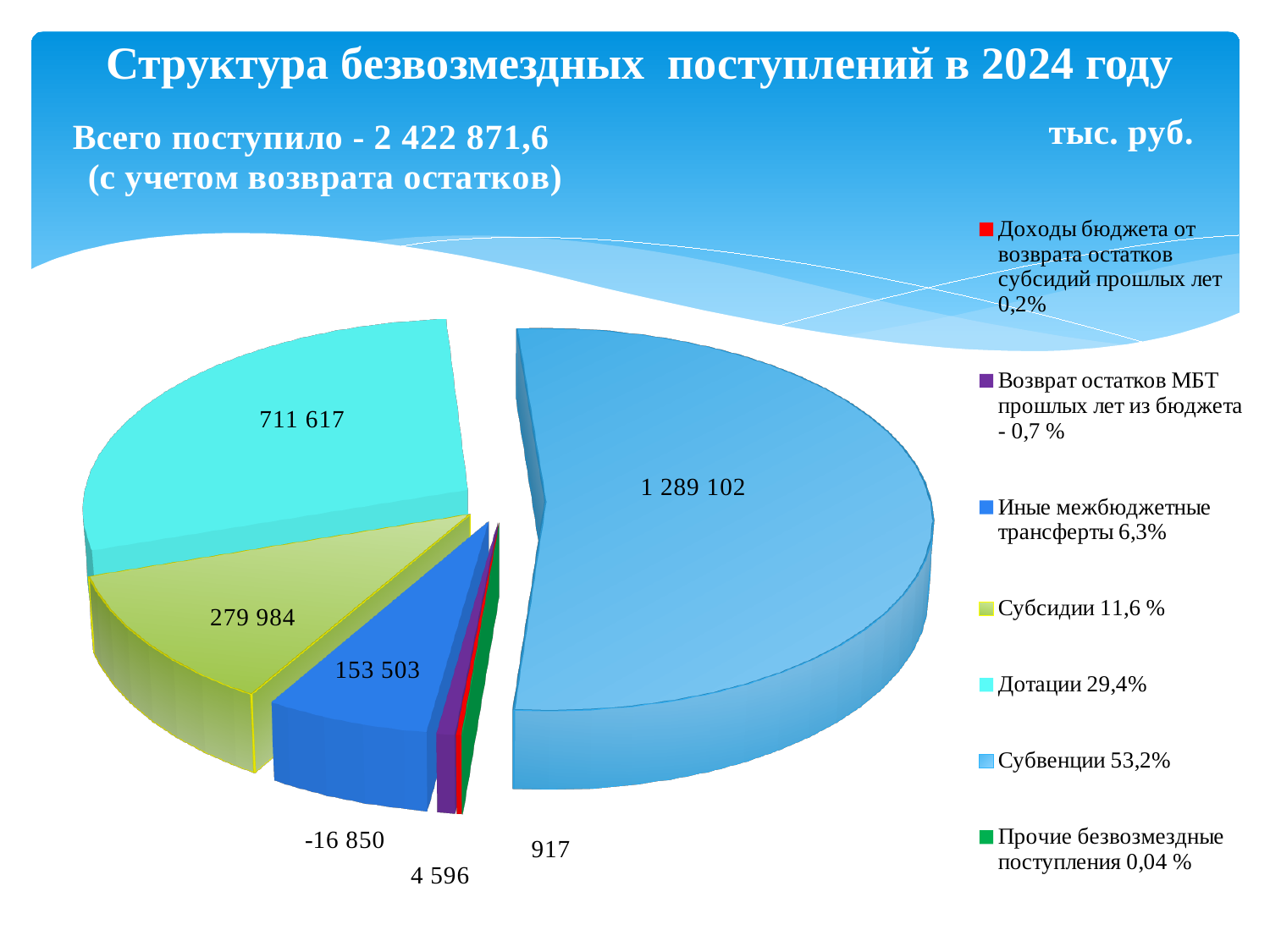
What is the title of the chart? Всего поступило - 2 422 871,6 (с учетом возврата остатков) What is the difference between the values for Субвенции and Дотации? 577 485 Which is larger, the value for Субсидии or the value for Иные межбюджетные трансферты? Субсидии Which category has the largest slice of the pie? Субвенции How many categories does the legend list? 7 What is the value for Субвенции? 1 289 102 What share of the pie does Субсидии represent, according to the legend? 11,6 % What type of chart is shown on the slide? pie chart What is the value for Иные межбюджетные трансферты? 153 503 What is the value for Дотации? 711 617 What is the value for Субсидии? 279 984 What share of the pie does Дотации represent, according to the legend? 29,4%